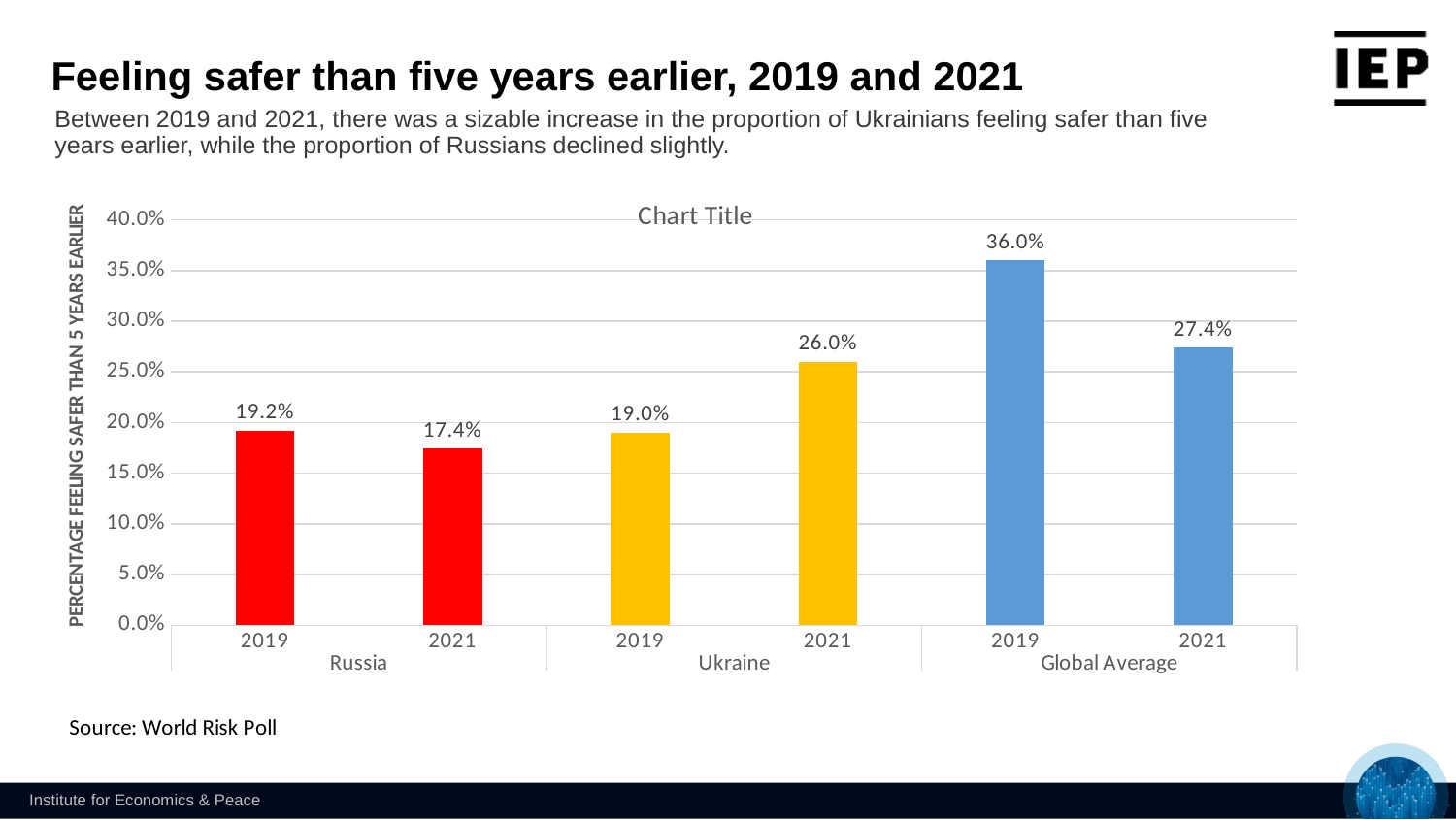
What is the difference between the Global Average values for 2019 and 2021? 8.6% What percentage of Russians felt safer than five years earlier in 2019? 19.2% By how many percentage points did the Ukraine value increase from 2019 to 2021? 7.0% Which is larger, the Russia 2021 value or the Ukraine 2021 value? Ukraine 2021 How many bars are plotted on the chart? 6 What type of chart is shown on the slide? Bar chart What is the value for Ukraine in 2021? 26.0% Which bar has the lowest value on the chart? Russia 2021 Which bar has the highest value on the chart? Global Average 2019 What is the Global Average value for 2019? 36.0% Is the Global Average value for 2021 greater or less than 25.0%? greater What is the label on the vertical axis of the chart? PERCENTAGE FEELING SAFER THAN 5 YEARS EARLIER